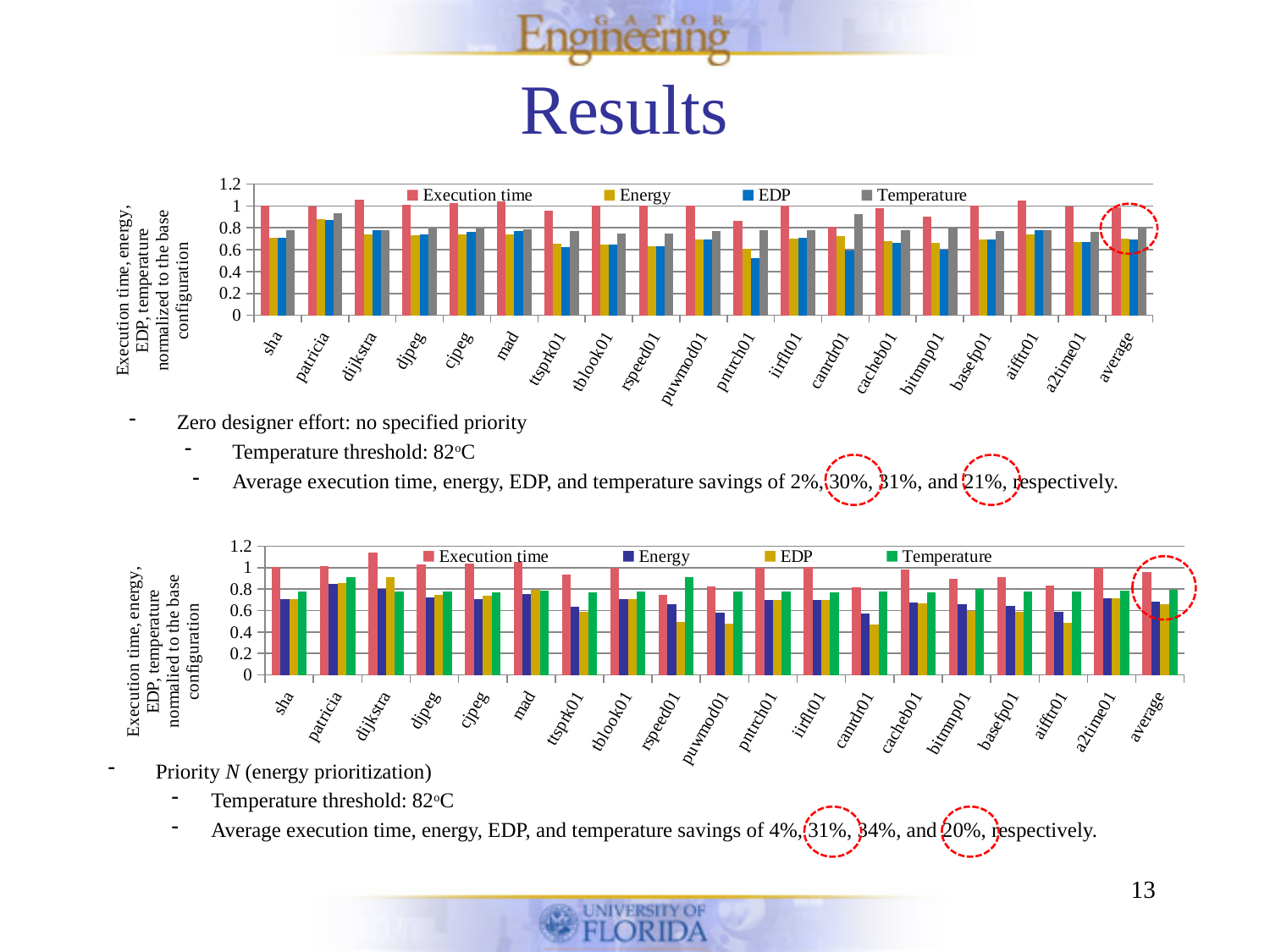
How many series does the legend of the top chart list? 4 How many categories are shown along the x axis of the bottom chart? 19 In the bottom chart, what colour are the Temperature bars? green In the bottom chart, which is larger for rspeed01: Temperature or EDP? Temperature In the top chart, which is larger for canrdr01: Temperature or EDP? Temperature What is the last category on the x axis of the top chart? average What kind of chart is the top chart on the slide? bar chart In the bottom chart, is the EDP value for puwmod01 greater or less than 0.6? less In the bottom chart, is the Execution time value for dijkstra greater or less than 1? greater In the bottom chart, which category has the highest Execution time value? dijkstra In the top chart, is the Temperature value for canrdr01 greater or less than 0.8? greater